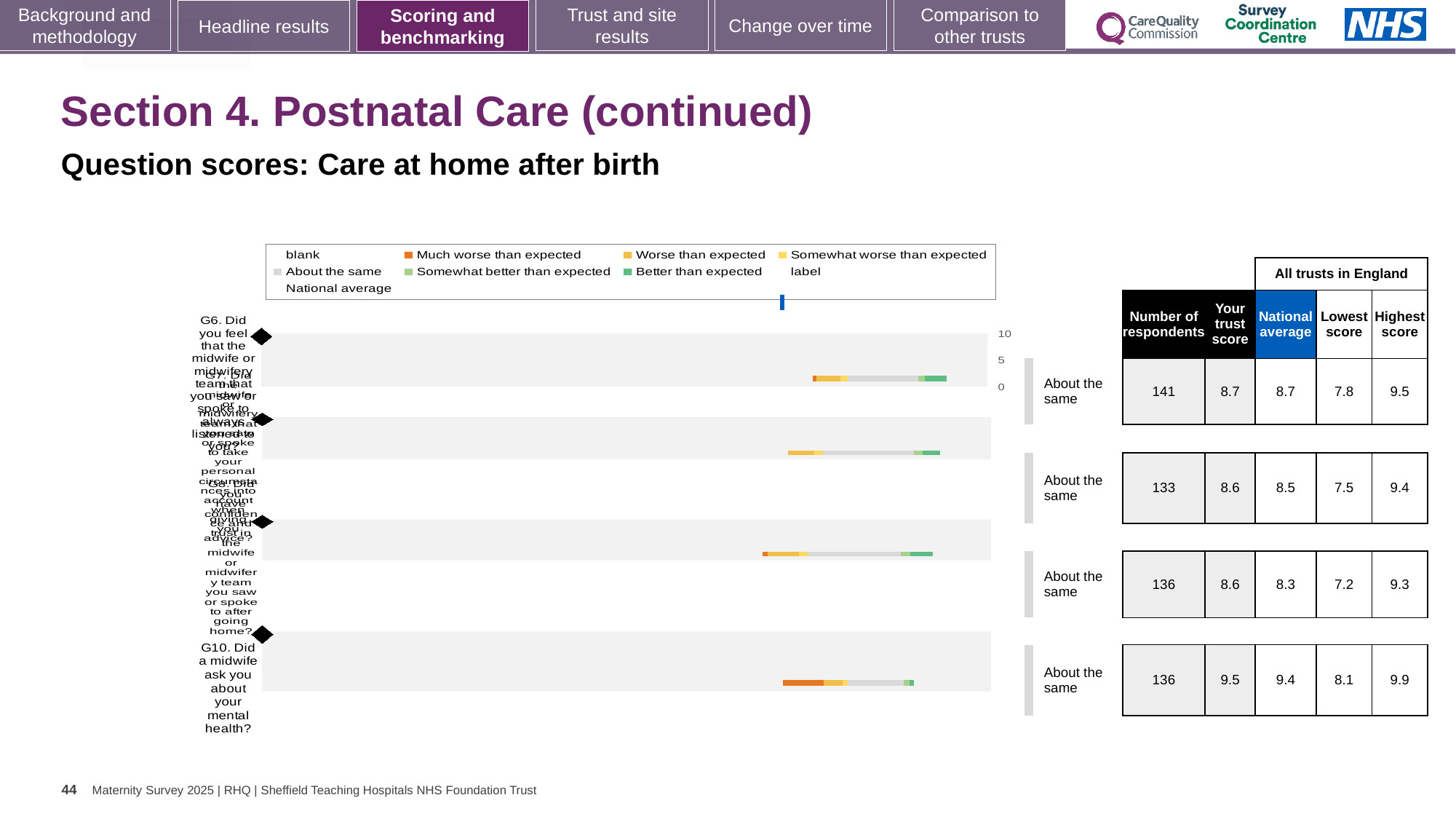
How many respondents answered G6 (Did you feel that the midwife or midwifery team listened to you?)? 141 What kind of chart is shown on the slide? bar chart How many question rows are plotted in the chart? 4 For the third question row (G8), which is larger: the trust score or the national average? the trust score (8.6) What is the lowest score across all trusts in England for G6? 7.8 What is the trust score for G10 (Did a midwife ask you about your mental health?)? 9.5 What is the national average for G10 (mental health)? 9.4 What is the difference between the highest score and the lowest score for G10 (mental health)? 1.8 Which question row has the highest trust score? G10 (mental health) Which legend entry is shown in dark orange? Much worse than expected What benchmark rating is shown for all four question rows? About the same What is the highest score across all trusts in England for the second question row (G7)? 9.4